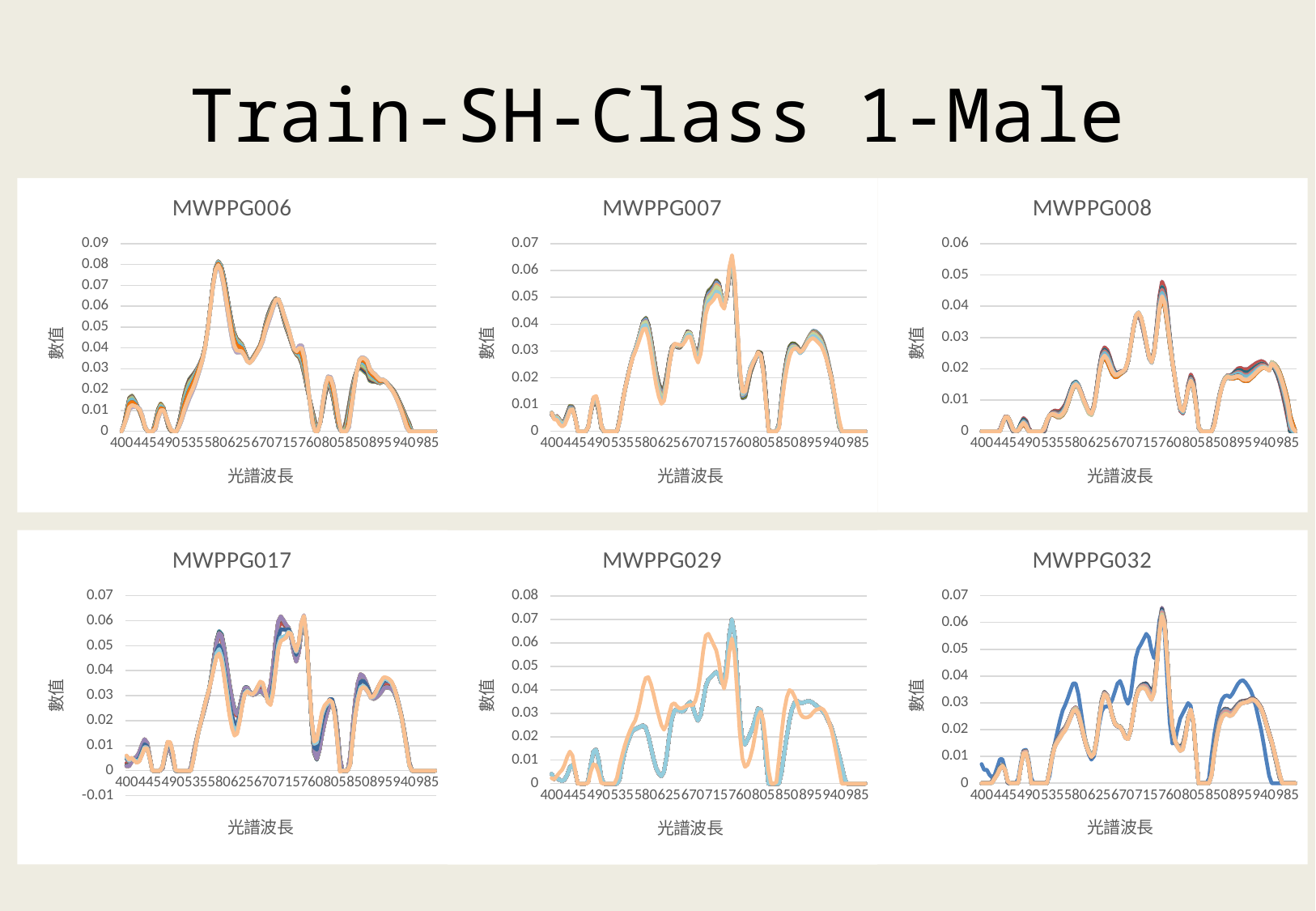
How many charts are shown on the slide? 6 In the MWPPG007 chart, is the highest peak greater or less than 0.06? greater In the MWPPG032 chart, is the highest peak greater or less than 0.06? greater What is the title of the top-left chart? MWPPG006 In the MWPPG032 chart, which line reaches a higher value near 670: the dark blue line or the light orange line? dark blue In the MWPPG006 chart, is the peak near 580 higher or lower than the peak near 715? higher In the MWPPG006 chart, is the highest peak (near 580) greater or less than 0.07? greater What kind of chart is MWPPG006? line chart